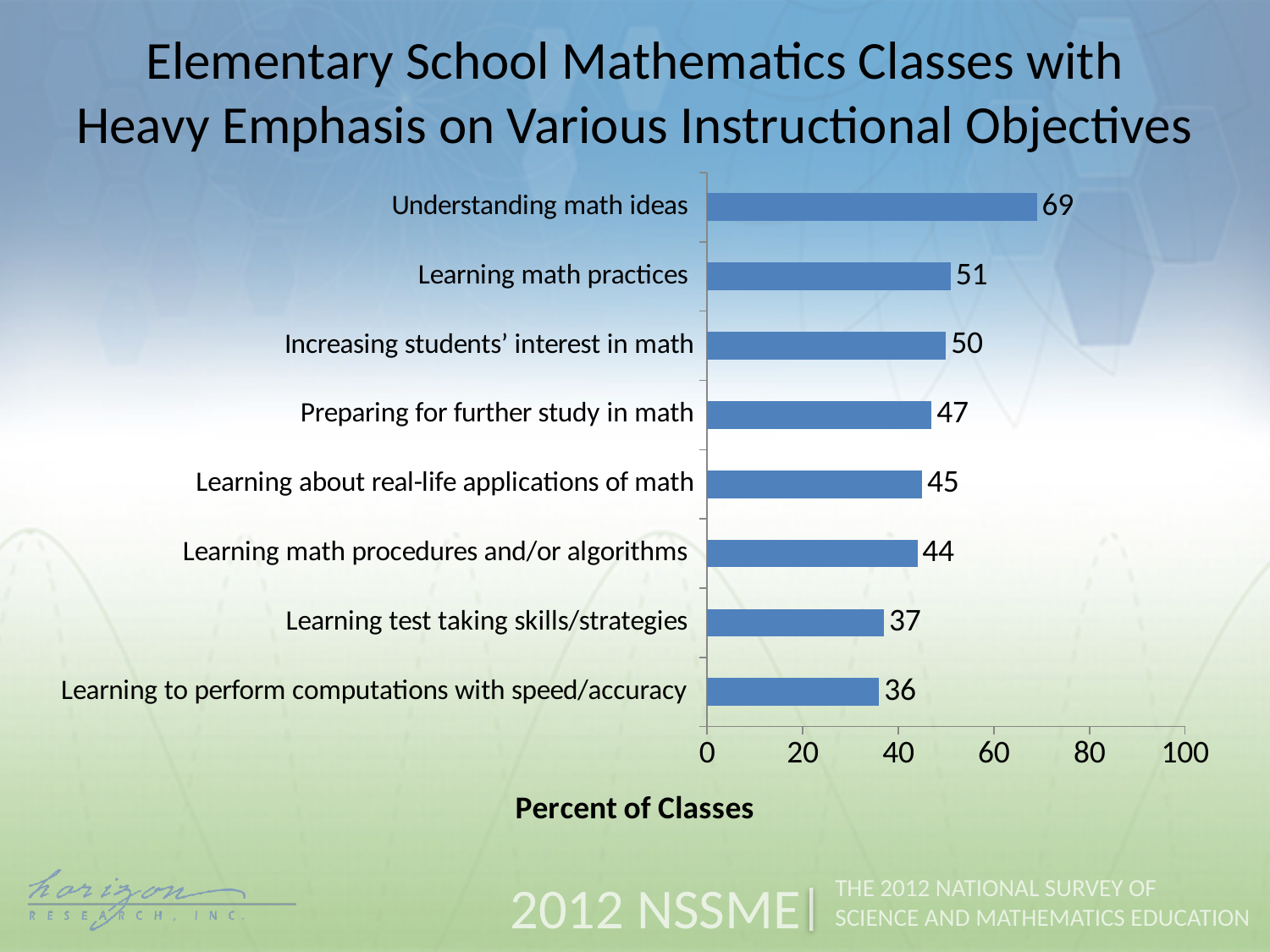
Which instructional objective has the lowest percent of classes? Learning to perform computations with speed/accuracy How many instructional objectives are shown in the chart? 8 What is the label of the horizontal axis? Percent of Classes Is the value for learning about real-life applications of math greater or less than 40? greater What is the value for learning test taking skills/strategies? 37 What is the difference between the values for learning math practices and preparing for further study in math? 4 Which is larger: the value for increasing students' interest in math or the value for learning math procedures and/or algorithms? Increasing students' interest in math Which instructional objective has the highest percent of classes? Understanding math ideas What is the value for learning math practices? 51 What percent of classes place heavy emphasis on understanding math ideas? 69 What is the difference between the values for understanding math ideas and learning to perform computations with speed/accuracy? 33 What kind of chart is shown on the slide? Bar chart